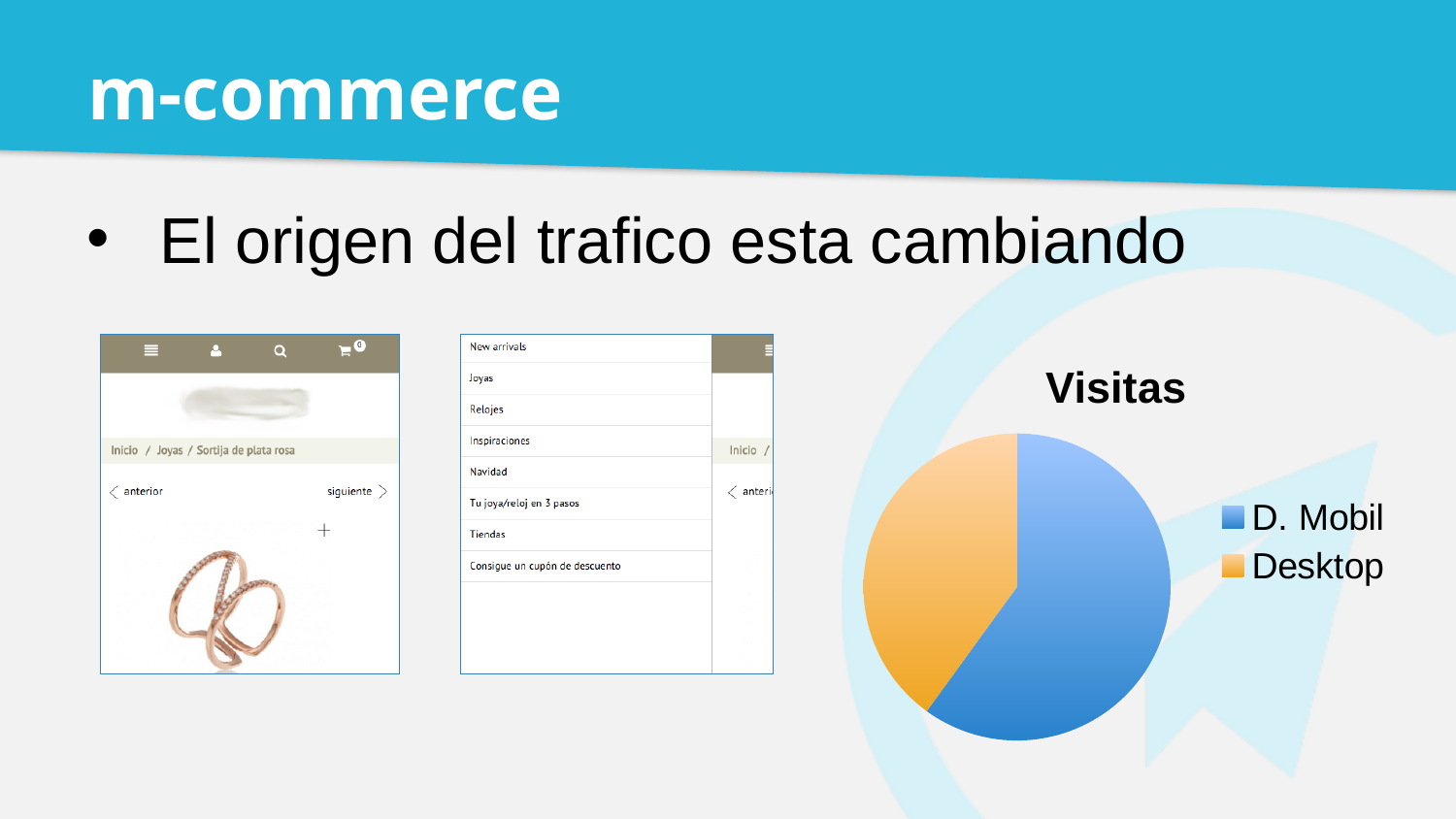
What kind of chart is shown on the slide? pie chart Which category has the smallest slice in the pie chart? Desktop Which category has the largest slice in the pie chart? D. Mobil Which slice is larger in the pie chart, D. Mobil or Desktop? D. Mobil How many entries does the legend of the pie chart list? 2 What colour is the Desktop slice in the pie chart? orange How many slices does the pie chart have? 2 What is the title of the pie chart? Visitas